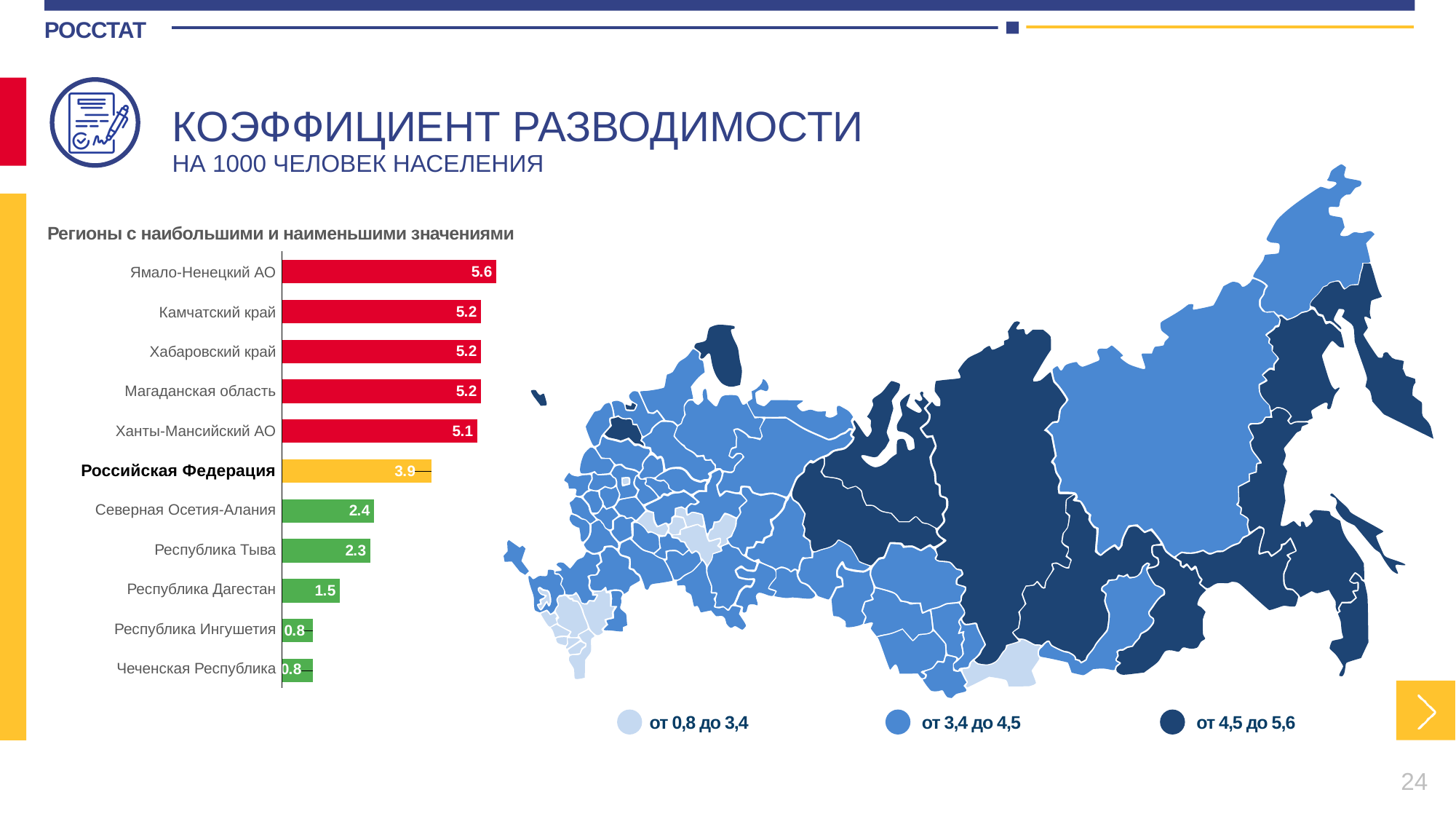
What is the difference between the value for Ямало-Ненецкий АО and the value for Российская Федерация? 1.7 How many regions (bars) are shown in the bar chart? 11 What value does the bar chart show for Российская Федерация? 3.9 What is the difference between the values for Северная Осетия-Алания and Республика Дагестан? 0.9 Which has a larger value, Камчатский край or Ханты-Мансийский АО? Камчатский край What kind of chart is used to show the regions with the highest and lowest values? Bar chart Which region has the highest value in the bar chart? Ямало-Ненецкий АО What value is shown for Ханты-Мансийский АО? 5.1 How many value ranges does the map legend list? 3 What is the value shown for Республика Дагестан? 1.5 Which has a larger value, Северная Осетия-Алания or Республика Тыва? Северная Осетия-Алания What is the divorce rate value shown for Ямало-Ненецкий АО in the bar chart? 5.6